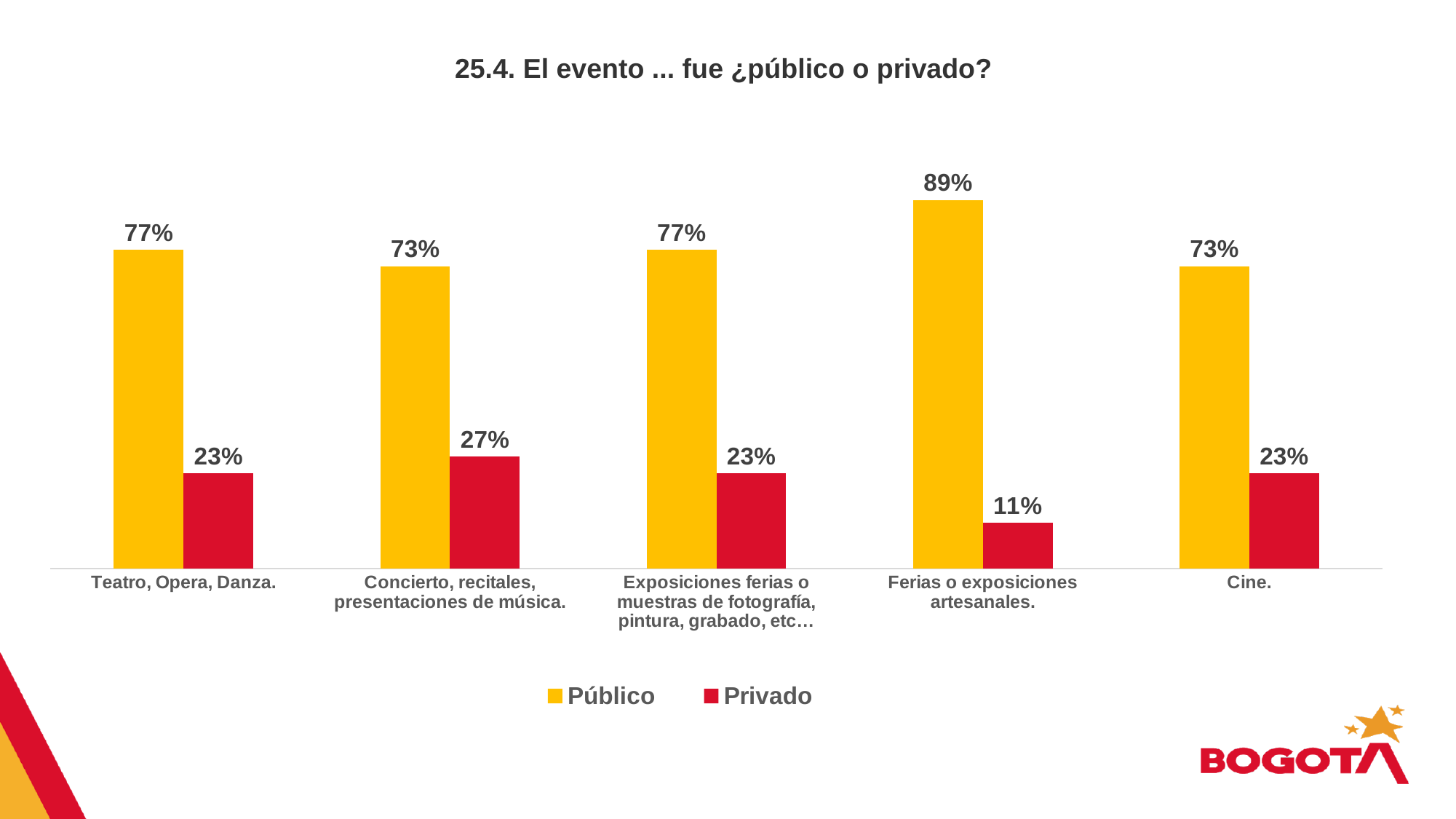
What is the difference between the Público and Privado values for Teatro, Opera, Danza.? 54% How many categories are shown on the x axis? 5 Which colour represents the Privado series in the legend? Red What is the Privado value for Ferias o exposiciones artesanales.? 11% What is the Privado value for Concierto, recitales, presentaciones de música.? 27% Which category has the lowest Privado value? Ferias o exposiciones artesanales. How many series does the legend list? 2 What is the Público value for Cine.? 73% What is the total of the Público and Privado values for Exposiciones ferias o muestras de fotografía, pintura, grabado, etc…? 100% Which is larger: the Privado value for Concierto, recitales, presentaciones de música. or the Privado value for Cine.? Concierto, recitales, presentaciones de música. What kind of chart is shown on the slide? Bar chart Which category has the highest Público value? Ferias o exposiciones artesanales.